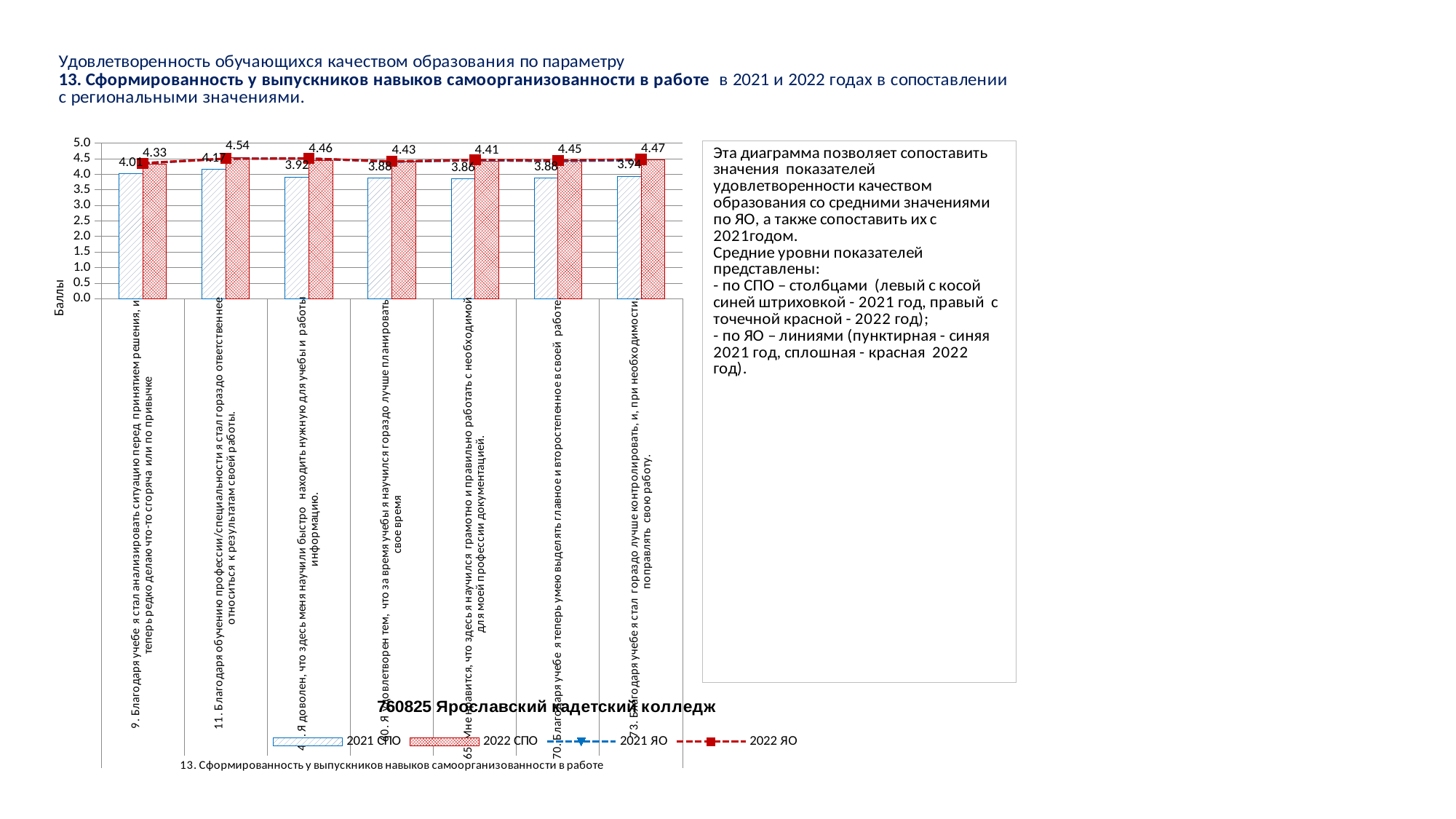
How many series does the chart legend list? 4 Which category has the highest 2021 СПО value? 11. Благодаря обучению профессии/специальности я стал гораздо ответственнее относиться к результатам своей работы Which is larger: the 2021 СПО value for category 9 or for category 73? Category 9 (4.01) What is the 2021 СПО value for category 9 (Благодаря учебе я стал анализировать ситуацию перед принятием решения)? 4.01 What is the 2021 СПО value for category 73 (Благодаря учебе я стал гораздо лучше контролировать, и, при необходимости поправлять свою работу)? 3.94 What is the title of the y axis of the chart? Баллы Which category has the lowest 2021 СПО value? 65. Мне нравится, что здесь я научился грамотно и правильно работать с необходимой для моей профессии документацией How many categories (questions) are shown on the x axis of the chart? 7 What is the difference between the highest and lowest 2021 СПО values (4.17 and 3.86)? 0.31 What is the 2021 СПО value for category 11 (Благодаря обучению профессии/специальности я стал гораздо ответственнее относиться к результатам своей работы)? 4.17 What is the 2021 СПО value for category 65 (Мне нравится, что здесь я научился грамотно и правильно работать с необходимой для моей профессии документацией)? 3.86 Is the 2021 СПО value for category 65 greater or less than 4.0? less